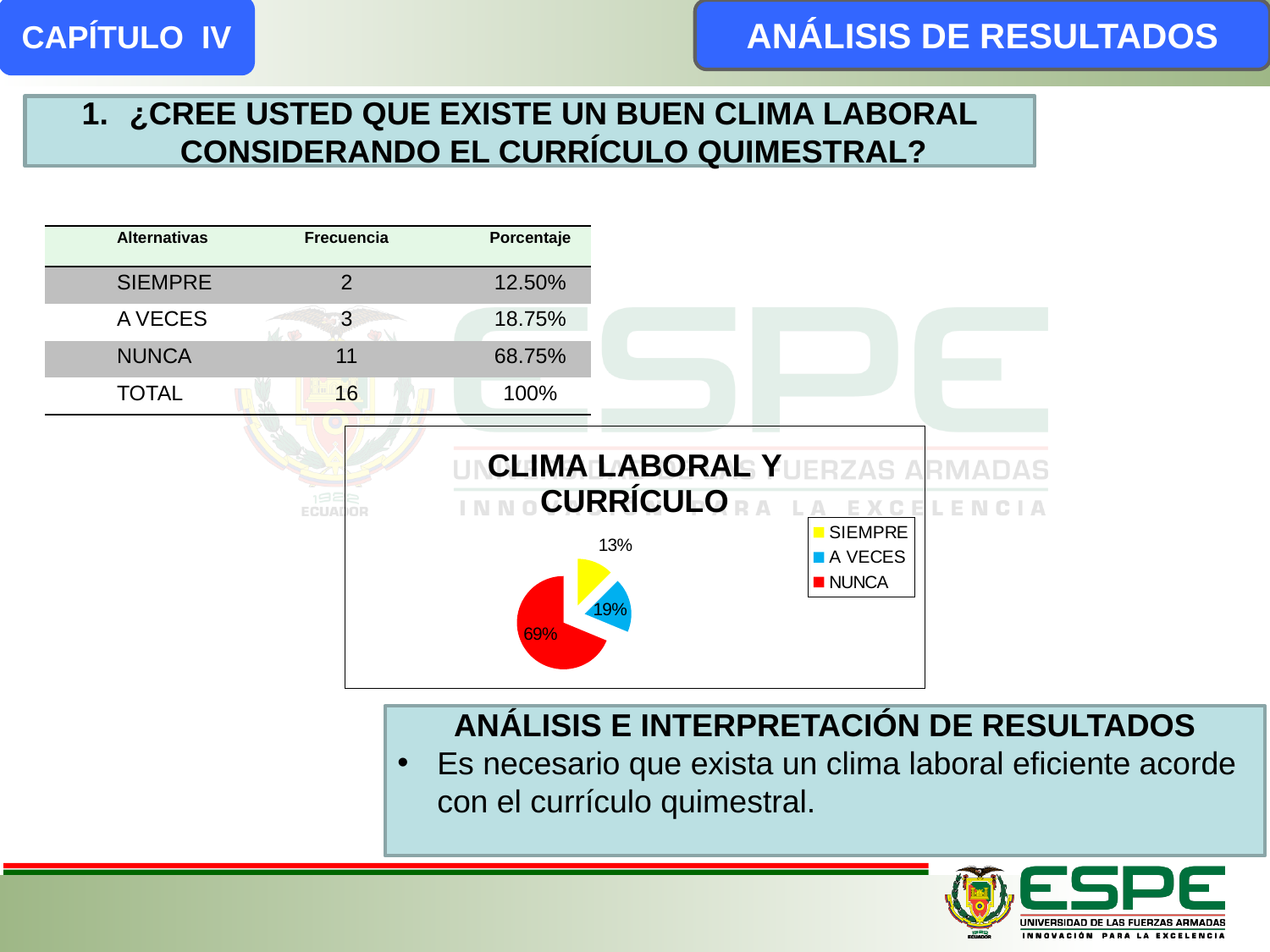
What percentage does the A VECES slice show in the pie chart? 19% Which category has the largest slice in the pie chart? NUNCA What is the difference in percentage points between the NUNCA slice and the A VECES slice? 50 Which category has the smallest slice in the pie chart? SIEMPRE What kind of chart is shown on the slide? pie chart What is the title of the chart? CLIMA LABORAL Y CURRÍCULO What percentage does the NUNCA slice show in the pie chart? 69% What percentage does the SIEMPRE slice show in the pie chart? 13% How many slices does the pie chart have? 3 What colour is the NUNCA slice in the pie chart? red How many entries does the chart legend list? 3 Which slice is larger in the pie chart, A VECES or SIEMPRE? A VECES